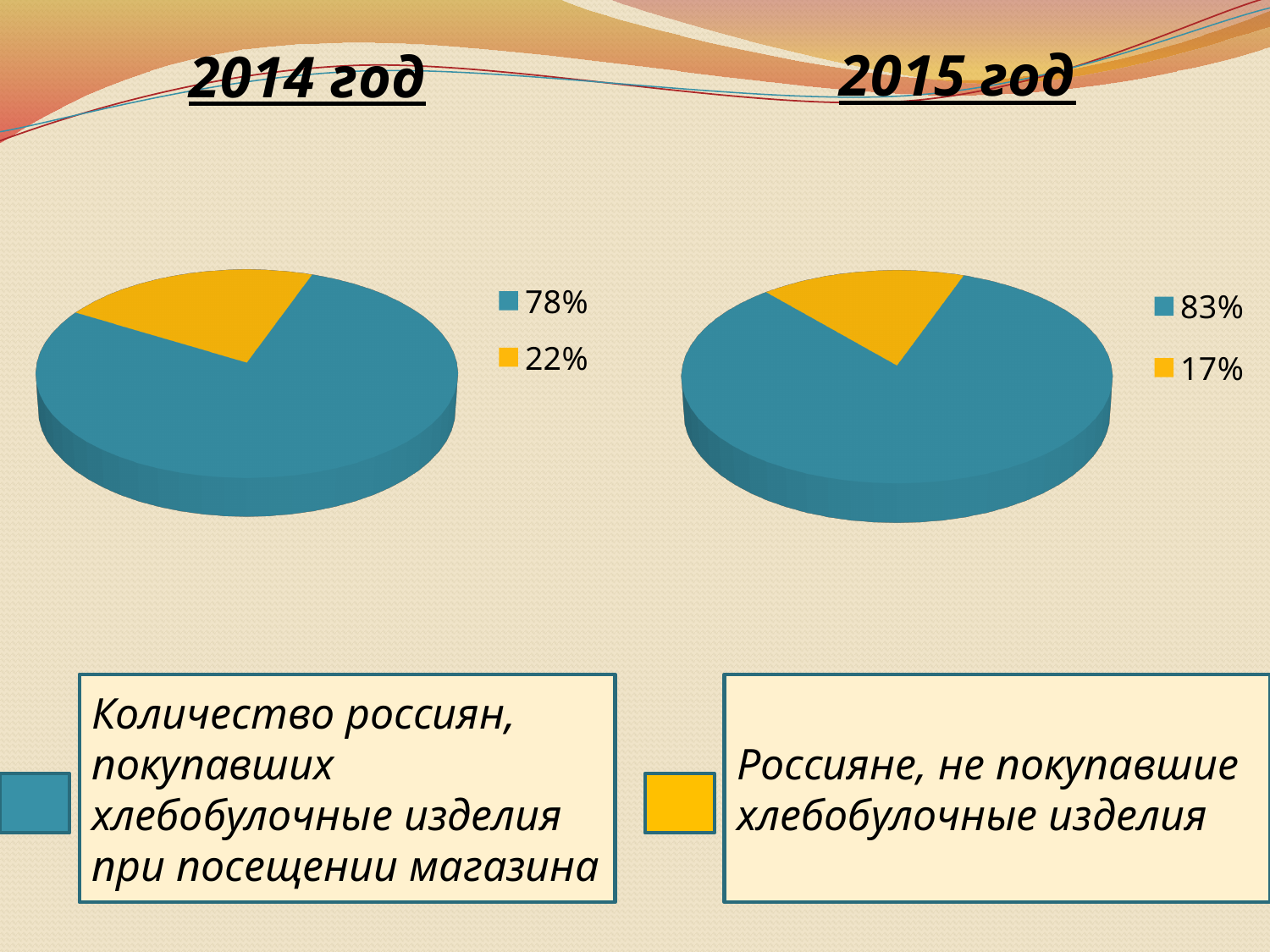
In the "2014 год" chart, which slice is the smallest? 22% (yellow, Russians who did not buy bakery products) In the "2015 год" chart, what share is shown for the blue slice (Russians who bought bakery products)? 83% In the "2014 год" chart, what share is shown for the blue slice (Russians who bought bakery products)? 78% In the "2014 год" chart, what share is shown for the yellow slice (Russians who did not buy bakery products)? 22% What is the difference between the blue slice in the "2015 год" chart and the blue slice in the "2014 год" chart? 5% In the "2015 год" chart, which slice is the largest? 83% (blue, Russians who bought bakery products) Which is larger: the yellow slice in the "2014 год" chart or the yellow slice in the "2015 год" chart? 2014 год (22%) In the "2015 год" chart, what share is shown for the yellow slice (Russians who did not buy bakery products)? 17% How many slices does the "2014 год" pie chart have? 2 According to the key at the bottom of the slide, what does the yellow colour represent? Россияне, не покупавшие хлебобулочные изделия How many entries does the legend of the "2015 год" chart list? 2 What kind of chart is shown under the heading "2014 год"? pie chart